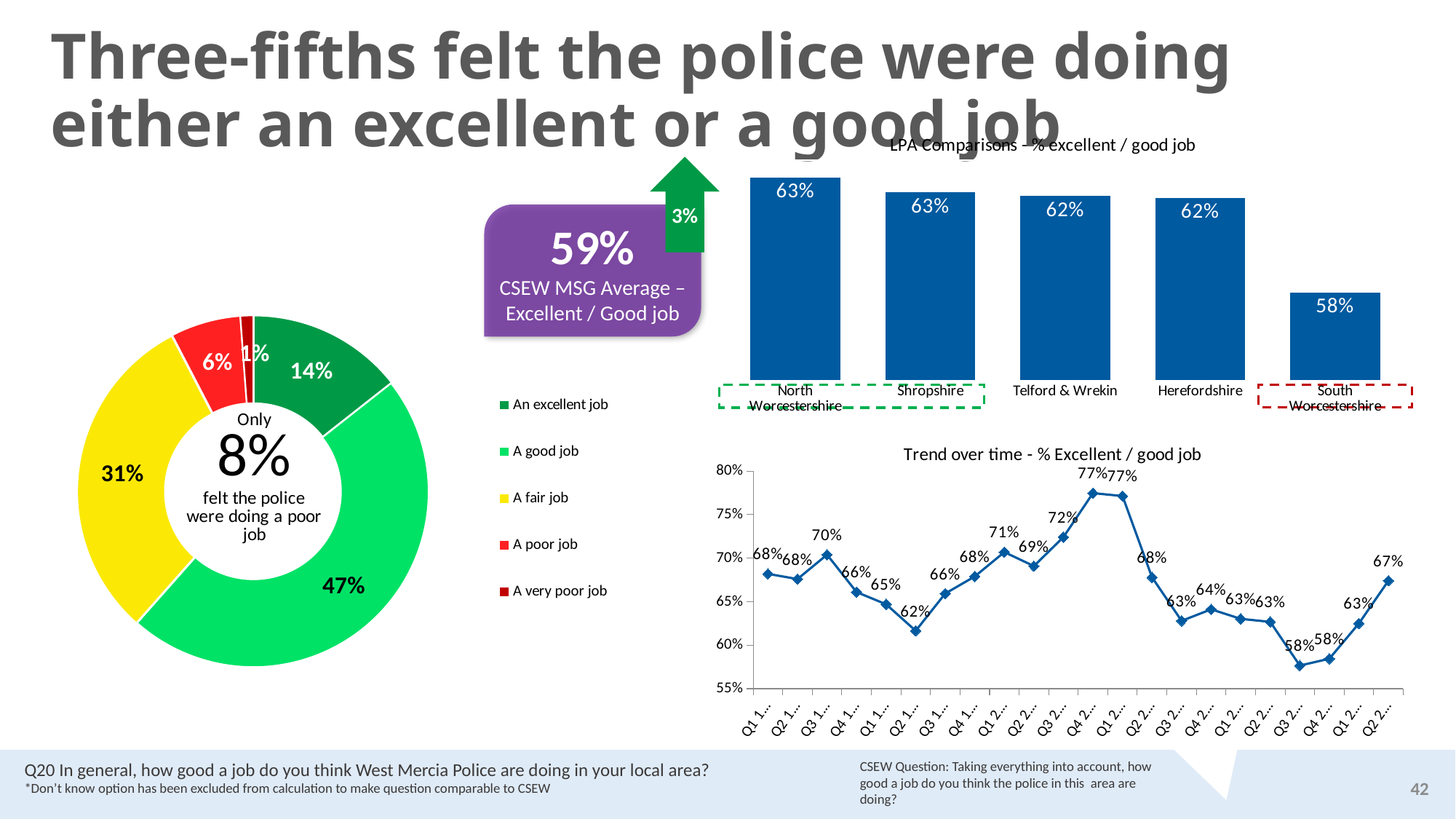
What kind of chart is 'Trend over time - % Excellent / good job'? Line chart In the 'LPA Comparisons - % excellent / good job' chart, what is the difference between Shropshire and South Worcestershire? 5% In the donut chart on the left, which response category has the smallest share? A very poor job In the donut chart on the left, what percentage said the police were doing a fair job? 31% In the 'LPA Comparisons - % excellent / good job' chart, which area has the lowest value? South Worcestershire In the 'LPA Comparisons - % excellent / good job' chart, what is the value for Telford & Wrekin? 62% In the donut chart on the left, how many response categories does the legend list? 5 In the 'Trend over time - % Excellent / good job' chart, what is the value of the last point on the right? 67% In the 'Trend over time - % Excellent / good job' chart, what is the highest value plotted? 77% In the 'LPA Comparisons - % excellent / good job' chart, what is the value for South Worcestershire? 58% In the donut chart on the left, which response category has the largest share? A good job In the donut chart on the left, what percentage said the police were doing a good job? 47%